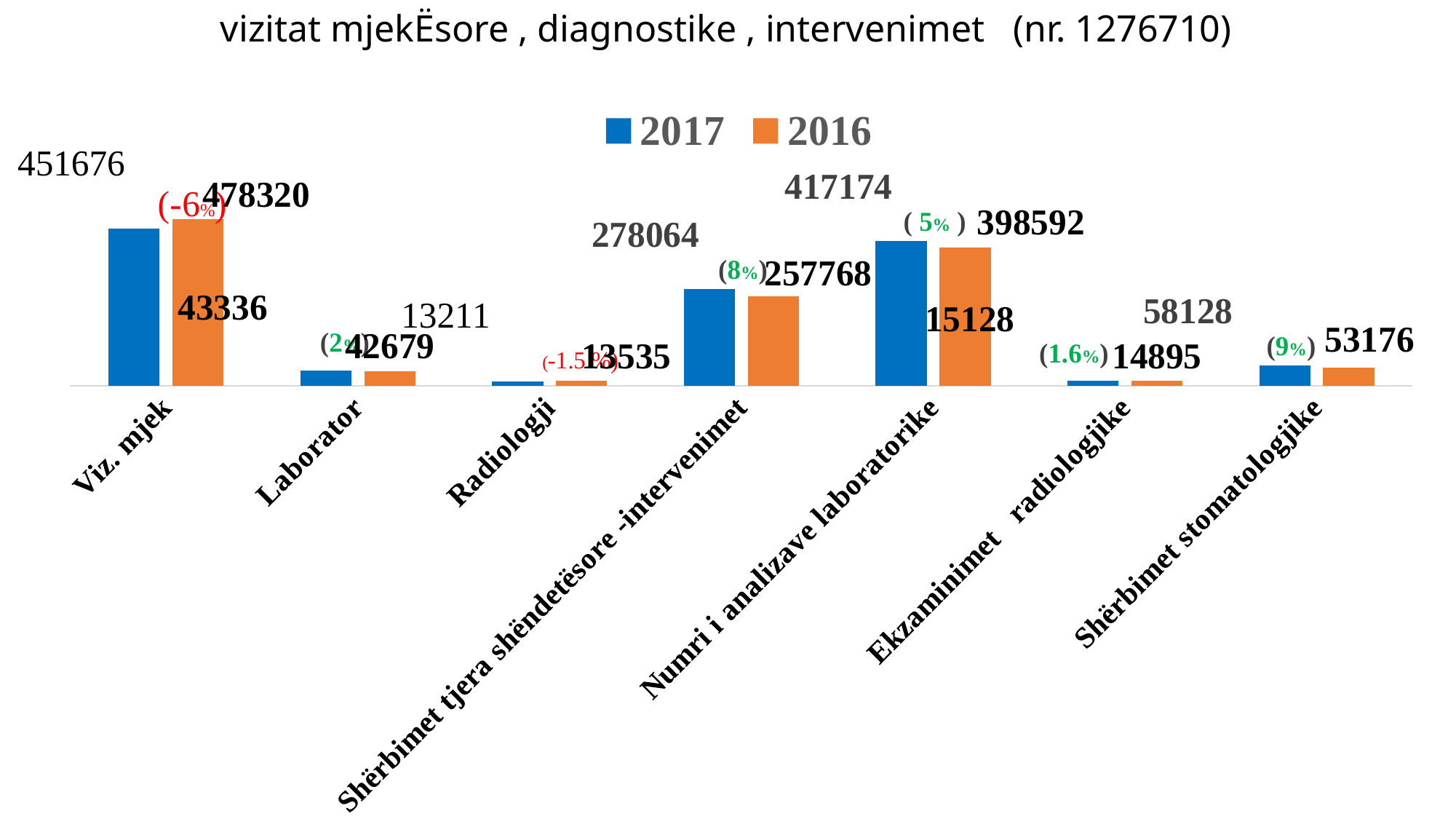
What is the 2016 value for Viz. mjek? 478320 What is the 2016 value for Shërbimet stomatologjike? 53176 What is the difference between the 2016 and 2017 values for Viz. mjek? 26644 What is the 2016 value for Ekzaminimet radiologjike? 14895 What kind of chart is shown on the slide? bar chart What is the 2017 value for Numri i analizave laboratorike? 417174 How many series does the legend list? 2 How many categories are shown on the x axis? 7 For Shërbimet tjera shëndetësore -intervenimet, which year has the larger value, 2017 or 2016? 2017 Which category has the lowest 2017 value? Radiologji Which category has the highest 2017 value? Viz. mjek What is the 2017 value for Viz. mjek? 451676